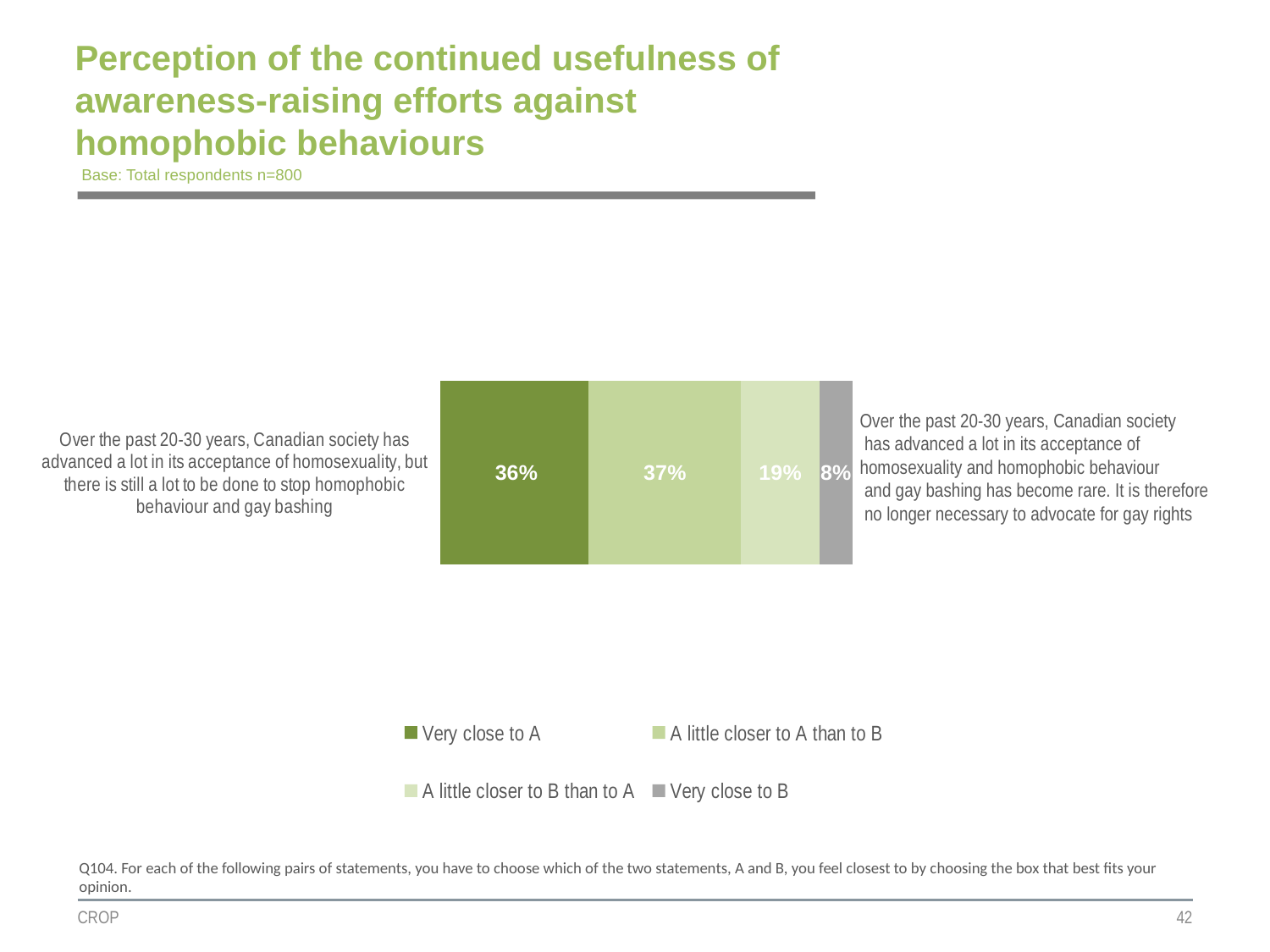
What percentage of respondents were "Very close to B"? 8% What is the difference between the "A little closer to B than to A" share and the "Very close to B" share? 11 percentage points What is the base (number of respondents) stated on the slide? n=800 What kind of chart is shown on the slide? Stacked bar chart What percentage of respondents were "A little closer to B than to A"? 19% What is the combined share of respondents who were "Very close to A" or "A little closer to A than to B"? 73% What percentage of respondents were "Very close to A"? 36% How many response categories does the legend list? 4 Which response category has the largest share? A little closer to A than to B Which response category has the smallest share? Very close to B What percentage of respondents were "A little closer to A than to B"? 37% Which is larger: the share for "Very close to A" or the share for "A little closer to B than to A"? Very close to A